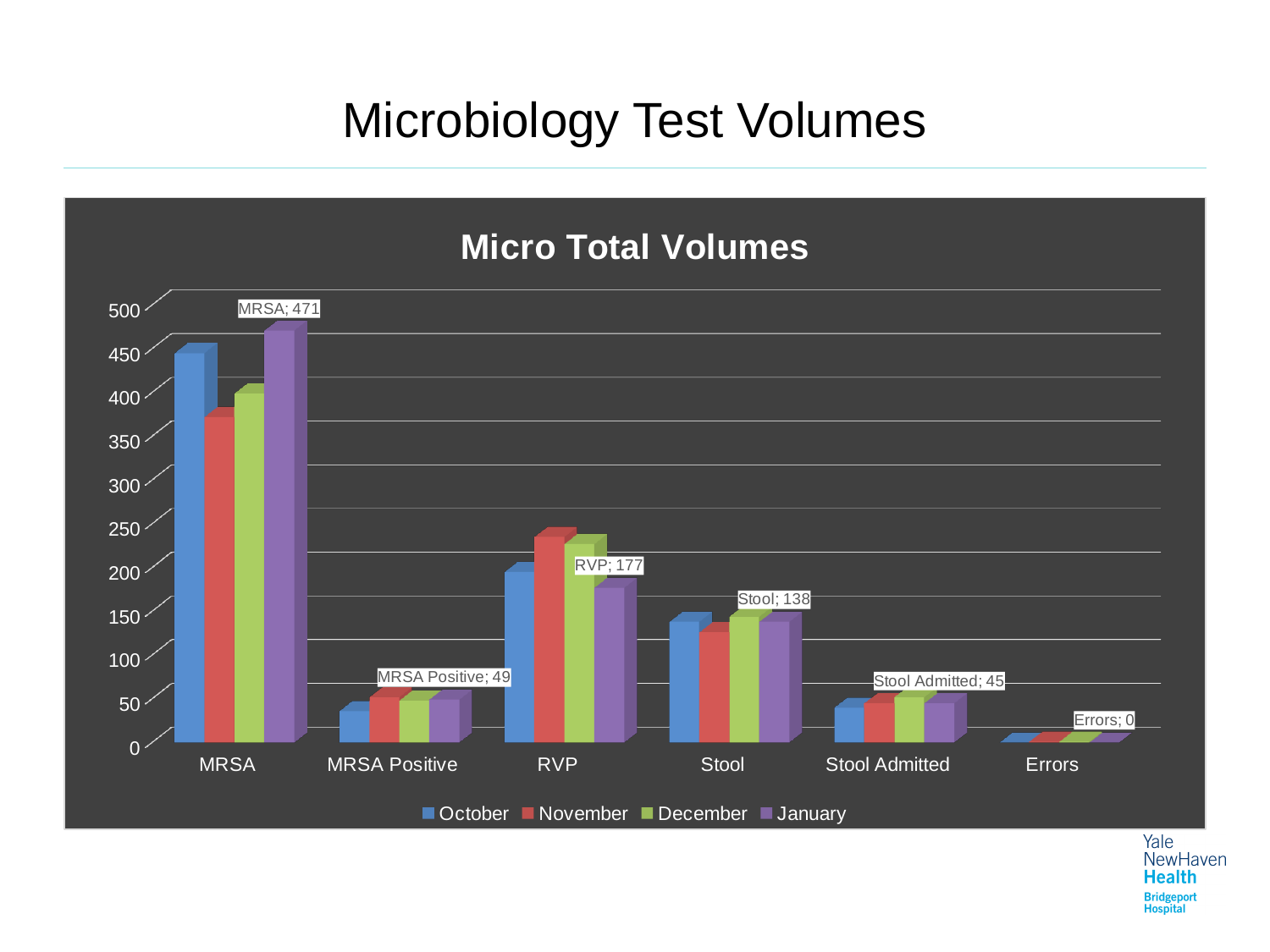
What is the difference between the January values for MRSA and RVP? 294 What type of chart is shown? Bar chart What is the January value for Errors? 0 Is the October value for MRSA greater or less than 400? greater How many series does the legend list? 4 Which category has the lowest January value? Errors What is the January value for RVP? 177 What is the January value for MRSA? 471 How many categories are shown on the x axis? 6 Which is larger, the January value for RVP or the January value for Stool? RVP Which category has the highest January value? MRSA What is the January value for Stool Admitted? 45